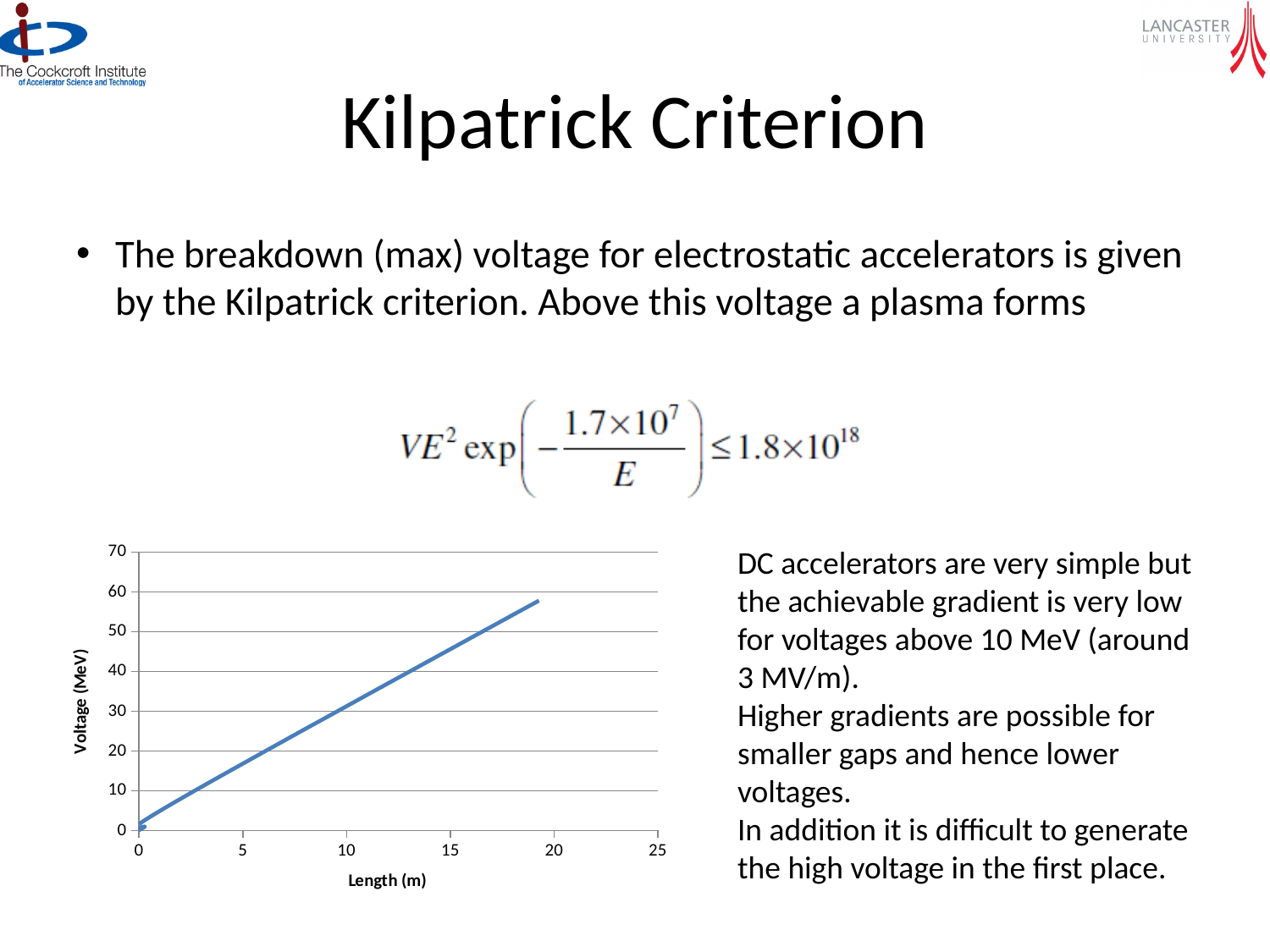
Is the voltage at a length of 5 m greater or less than 20 MeV? less Is the voltage at a length of 5 m greater or less than 10 MeV? greater Is the voltage at a length of 10 m greater or less than 40 MeV? less What is the largest value shown on the horizontal axis of the chart? 25 Does the voltage rise or fall as the length increases along the x axis? rise What kind of chart is shown on the slide? line chart What is the label of the vertical axis of the chart? Voltage (MeV) What is the label of the horizontal axis of the chart? Length (m) Is the voltage at a length of 15 m larger than the voltage at a length of 5 m? yes